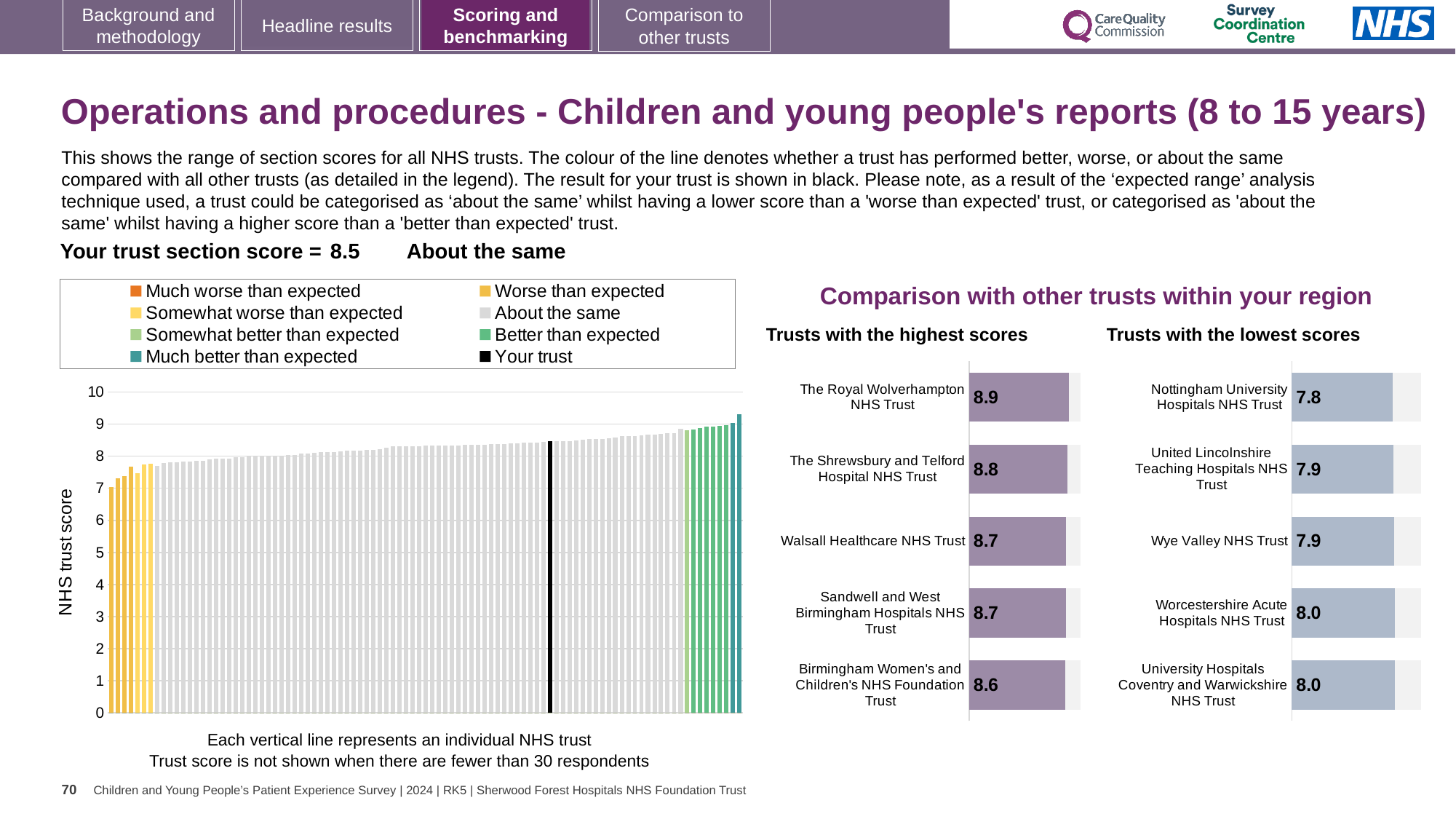
In the main chart on the left, is the value of the tallest green bar at the far right greater or less than 9? greater In the main chart on the left, is the value of the leftmost yellow bar greater or less than 8? less In the main chart on the left, how many entries does the legend list? 8 In the 'Trusts with the highest scores' chart, which trust has the lowest score? Birmingham Women's and Children's NHS Foundation Trust In the 'Trusts with the highest scores' chart, what is the difference between the scores of The Royal Wolverhampton NHS Trust and Birmingham Women's and Children's NHS Foundation Trust? 0.3 In the 'Trusts with the lowest scores' chart, which trust has the lowest score? Nottingham University Hospitals NHS Trust In the main chart on the left, what is the section score for your trust (the black bar)? 8.5 In the 'Trusts with the lowest scores' chart, how many trusts are shown? 5 In the 'Trusts with the lowest scores' chart, which has the larger score: Nottingham University Hospitals NHS Trust or Worcestershire Acute Hospitals NHS Trust? Worcestershire Acute Hospitals NHS Trust In the main chart on the left, what kind of chart is used to show the NHS trust scores? bar chart In the 'Trusts with the highest scores' chart, what is the score for The Royal Wolverhampton NHS Trust? 8.9 In the main chart on the left, do the trust scores rise or fall from left to right along the x axis? rise